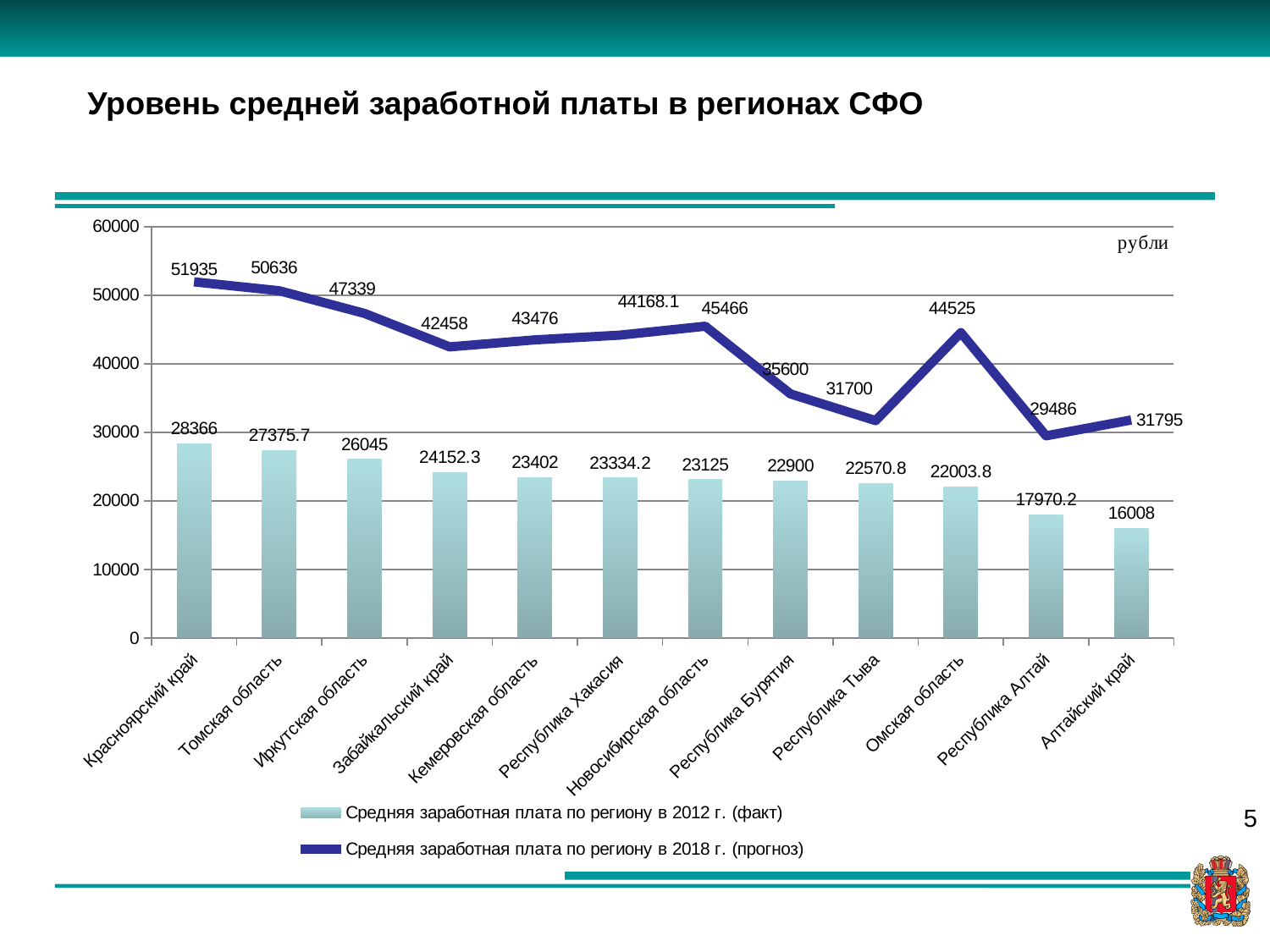
How many regions are shown on the x axis? 12 Which region has the lowest 2018 (forecast) average salary? Республика Алтай Which region has the highest 2018 (forecast) average salary? Красноярский край What is the difference between the 2018 forecast and the 2012 fact salary for Алтайский край? 15787 Which is larger: the 2018 forecast salary for Республика Бурятия or for Омская область? Омская область What unit is indicated in the top right corner of the chart? рубли What is the forecast average salary in 2018 for Омская область? 44525 What is the 2012 (fact) average salary for Республика Тыва? 22570.8 Do the 2012 (fact) bar values rise or fall from left to right along the x axis? fall How many series does the legend list? 2 Which region has the lowest 2012 (fact) average salary? Алтайский край What is the average salary in 2012 (fact) for Красноярский край? 28366